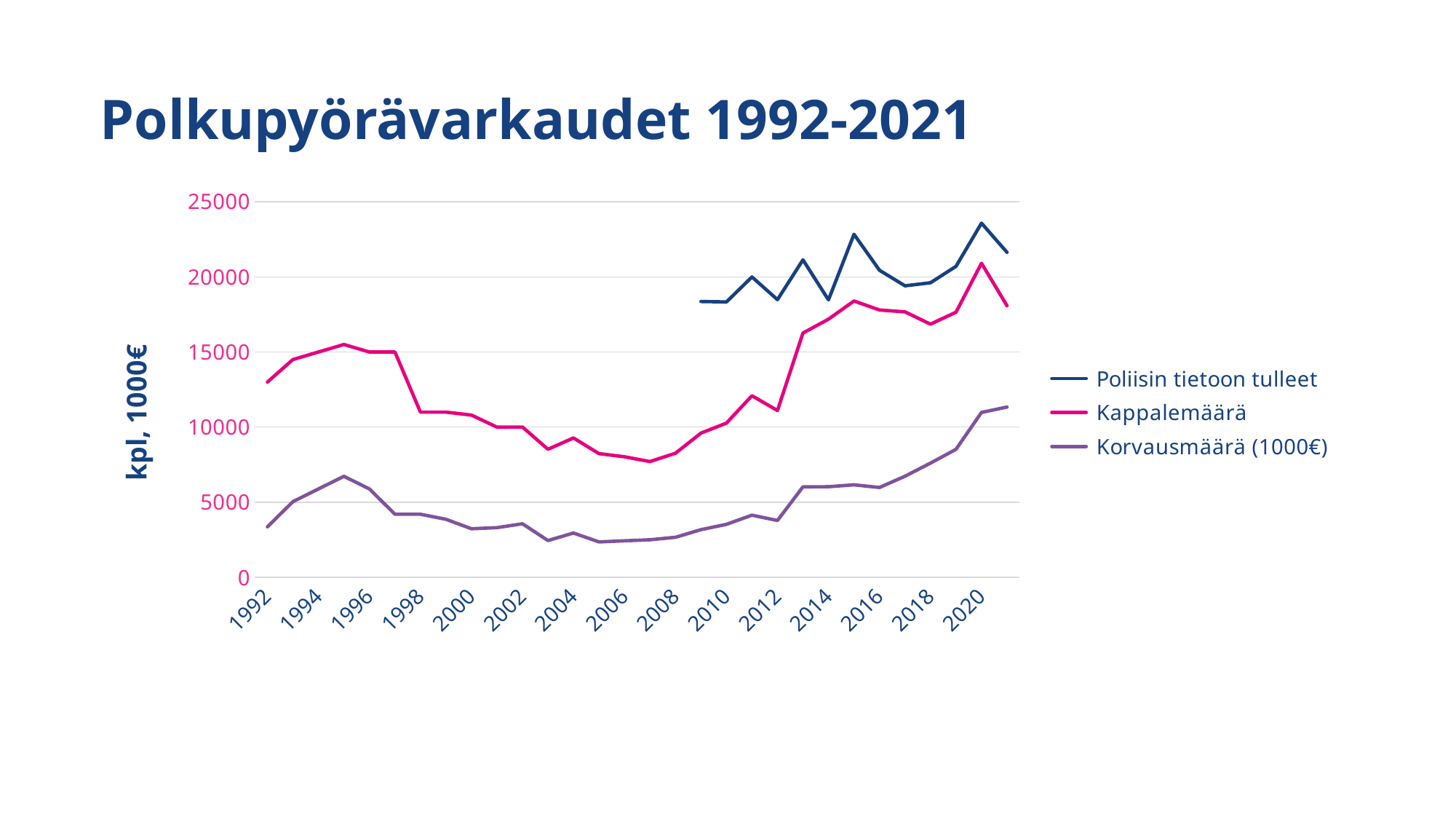
How many series does the legend list? 3 What is the label on the vertical axis? kpl, 1000€ Is the value for Korvausmäärä (1000€) in 2006 greater or less than 5000? less What is the title of the chart? Polkupyörävarkaudet 1992-2021 Is the value for Kappalemäärä in 2006 greater or less than 10000? less Does the Korvausmäärä (1000€) series rise or fall from 2012 to 2021? rise What kind of chart is shown on the slide? line chart Is the value for Poliisin tietoon tulleet in 2020 greater or less than 20000? greater In 2010, which is larger: Poliisin tietoon tulleet or Kappalemäärä? Poliisin tietoon tulleet In which year does the Kappalemäärä series reach its highest value? 2020